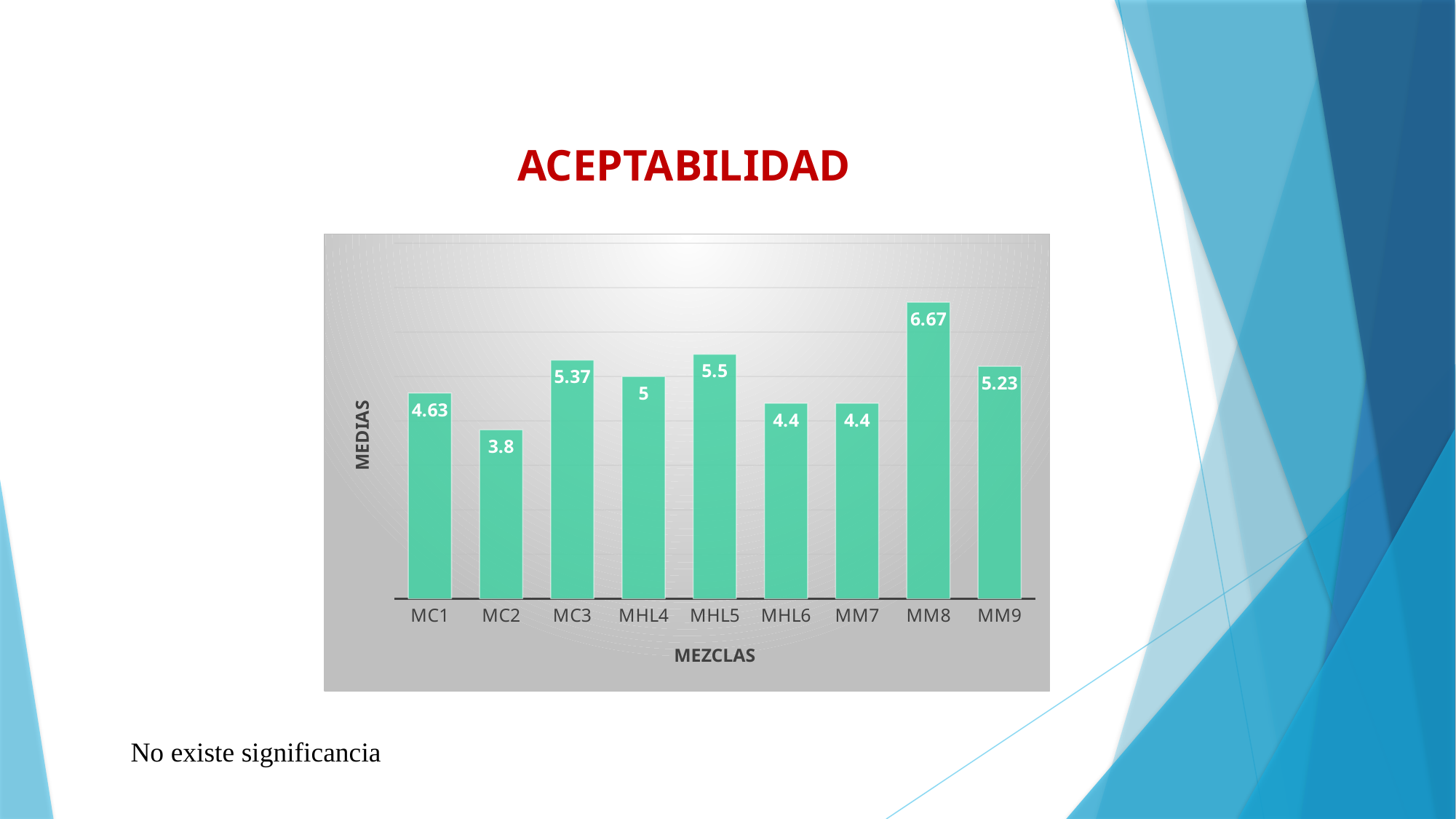
What is the difference between the values for MHL5 and MHL6? 1.1 Which mezcla has the highest value? MM8 How many mezclas are shown on the x axis? 9 What is the value for MC1? 4.63 What is the value for MHL4? 5 What is the title of the chart? ACEPTABILIDAD Which has a larger value, MC3 or MM9? MC3 What is the value for MM8? 6.67 What is the label of the y axis? MEDIAS Which mezcla has the lowest value? MC2 What is the difference between the values for MM8 and MC2? 2.87 What kind of chart is shown on the slide? Bar chart